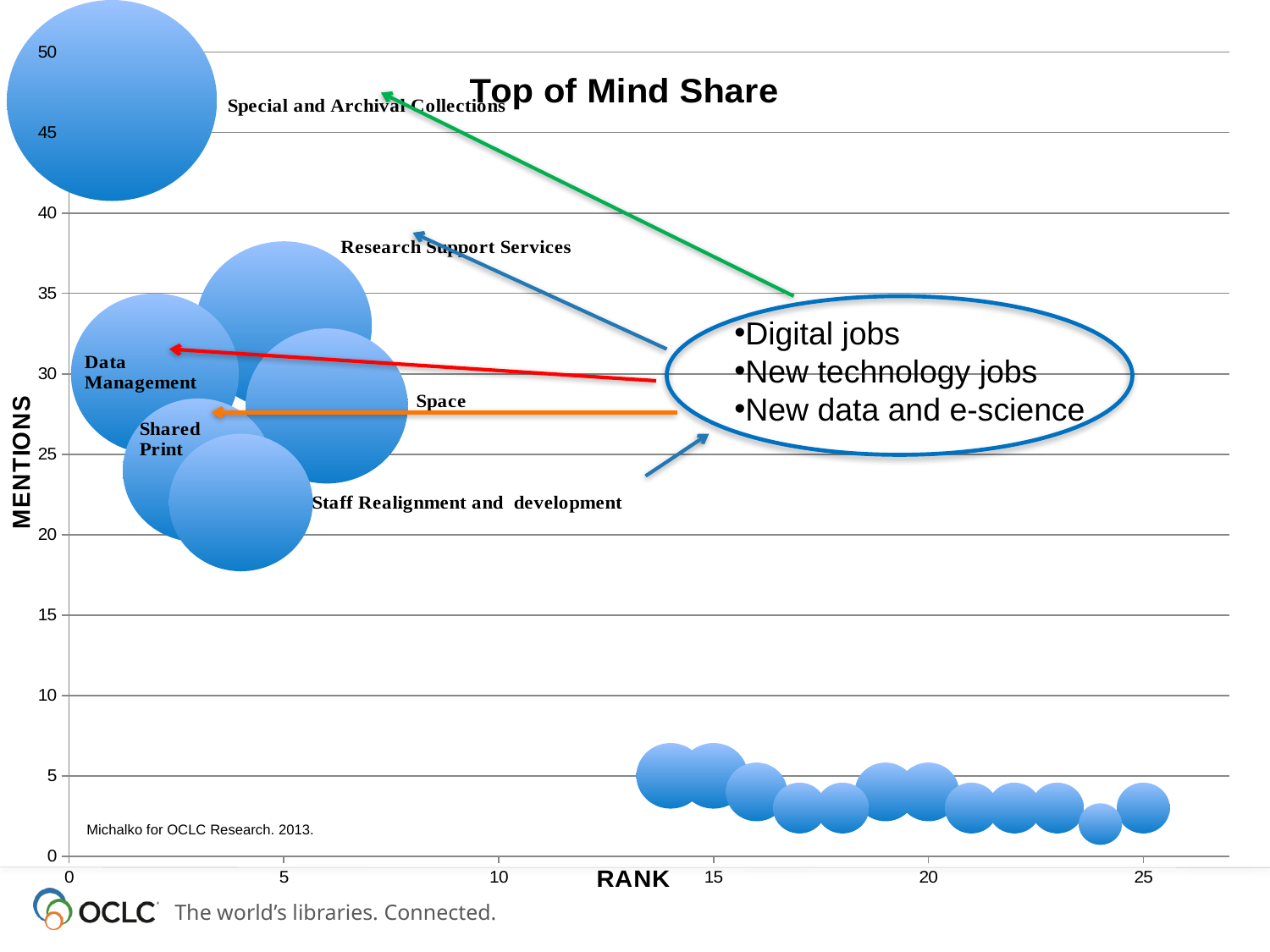
Is the number of mentions for Space greater or less than 25? greater Which labelled topic has the highest number of mentions? Special and Archival Collections Do mentions rise or fall as rank increases along the x axis? fall Is the number of mentions for Research Support Services greater or less than 30? greater What is the title of the chart? Top of Mind Share Which has more mentions, Data Management or Shared Print? Data Management Which has more mentions, Research Support Services or Data Management? Research Support Services What is the label on the vertical axis of the chart? MENTIONS Is the number of mentions for Special and Archival Collections greater or less than 40? greater What kind of chart is shown on the slide? bubble chart